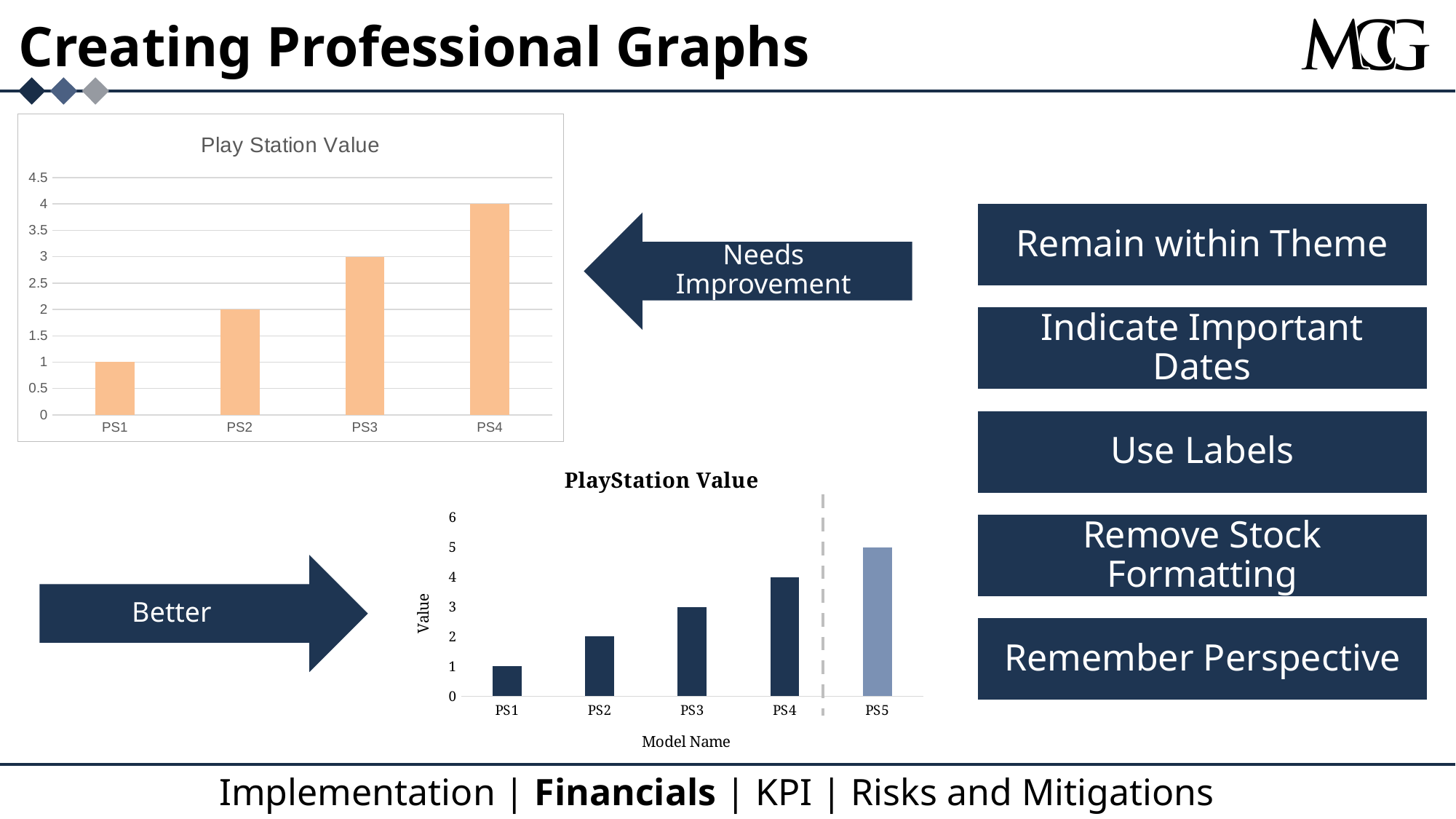
In the top chart titled 'Play Station Value', do the values rise or fall from PS1 to PS4? rise In the bottom chart titled 'PlayStation Value', how many categories are shown on the x axis? 5 In the bottom chart titled 'PlayStation Value', what is the label of the x axis? Model Name In the bottom chart titled 'PlayStation Value', which category has the highest value? PS5 In the bottom chart titled 'PlayStation Value', which is larger, the value for PS2 or the value for PS4? PS4 What kind of chart is the bottom chart titled 'PlayStation Value'? bar chart In the top chart titled 'Play Station Value', how many categories are shown on the x axis? 4 In the top chart titled 'Play Station Value', what is the difference between the values for PS3 and PS1? 2 In the top chart titled 'Play Station Value', what is the value for PS4? 4 In the bottom chart titled 'PlayStation Value', what is the difference between the values for PS5 and PS3? 2 In the top chart titled 'Play Station Value', which category has the lowest value? PS1 In the bottom chart titled 'PlayStation Value', what is the value for PS5? 5